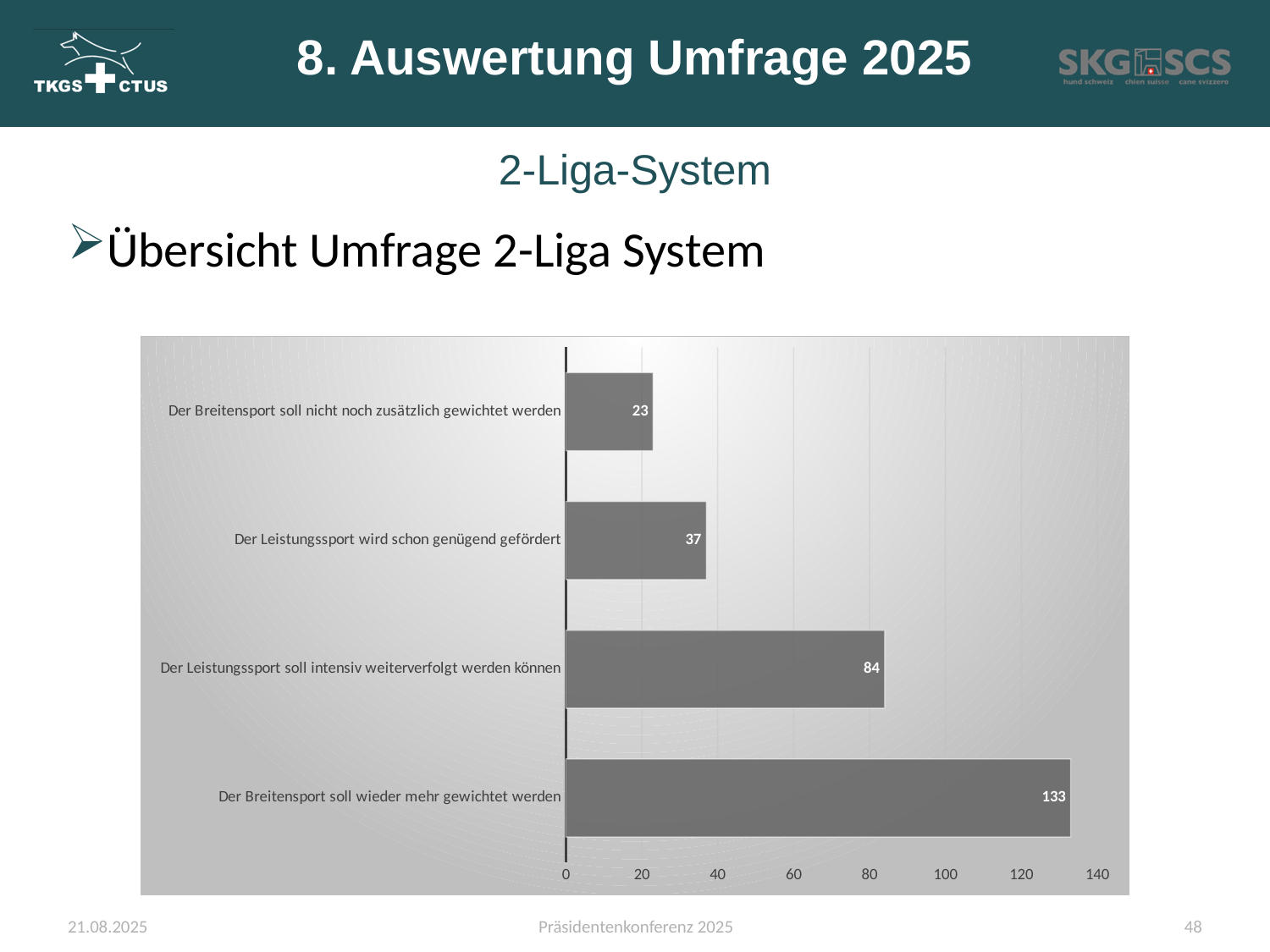
What is the value for "Der Leistungssport soll intensiv weiterverfolgt werden können"? 84 How many categories are shown in the chart? 4 What is the difference between the values for "Der Breitensport soll wieder mehr gewichtet werden" and "Der Leistungssport soll intensiv weiterverfolgt werden können"? 49 Which is larger: the value for "Der Leistungssport wird schon genügend gefördert" or for "Der Breitensport soll nicht noch zusätzlich gewichtet werden"? Der Leistungssport wird schon genügend gefördert What is the difference between the values for "Der Leistungssport wird schon genügend gefördert" and "Der Breitensport soll nicht noch zusätzlich gewichtet werden"? 14 What kind of chart is shown on the slide? bar chart Which category has the highest value? Der Breitensport soll wieder mehr gewichtet werden What is the value for "Der Breitensport soll nicht noch zusätzlich gewichtet werden"? 23 What is the value for "Der Leistungssport wird schon genügend gefördert"? 37 What is the value for "Der Breitensport soll wieder mehr gewichtet werden"? 133 Is the value for "Der Leistungssport soll intensiv weiterverfolgt werden können" greater or less than 100? less Which category has the lowest value? Der Breitensport soll nicht noch zusätzlich gewichtet werden